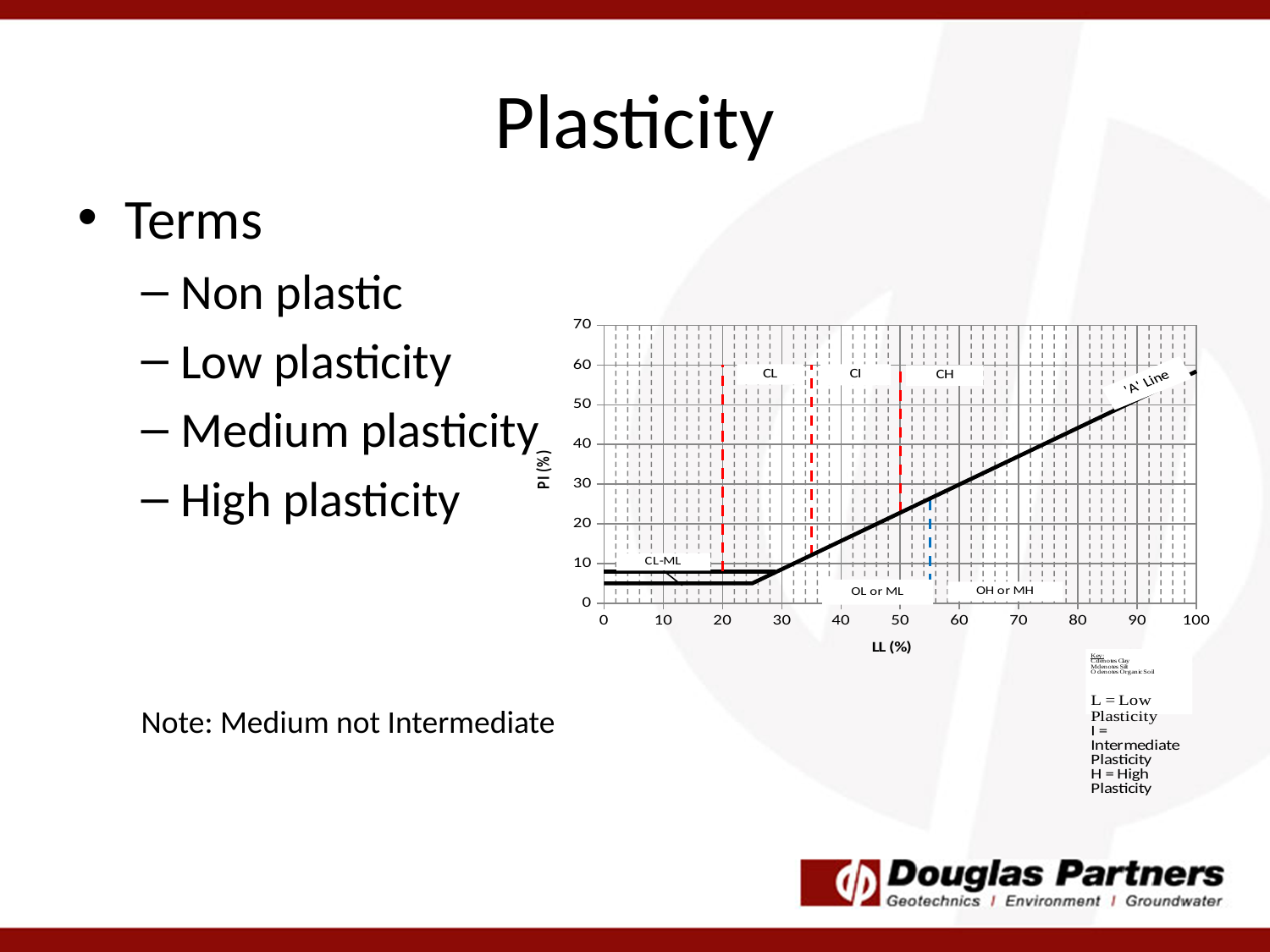
What is the label of the y axis of the chart? PI (%) On the 'A' Line, is the PI (%) value at LL = 70 greater or less than 30? greater On the 'A' Line, is the PI (%) value at LL = 70 greater or less than 40? less Does the 'A' Line rise or fall as LL (%) increases along the x axis? rise How many red dashed vertical lines are drawn on the chart? 3 What is the highest value shown on the y axis (PI (%)) of the chart? 70 What is the label of the x axis of the chart? LL (%) What is the name of the sloping solid line on the chart? 'A' Line On the 'A' Line, is the PI (%) value at LL = 80 greater or less than 40? greater What is the highest value shown on the x axis (LL (%)) of the chart? 100 Which zone label appears between the CL and CH labels at the top of the chart? CI What kind of chart is shown on the slide? line chart